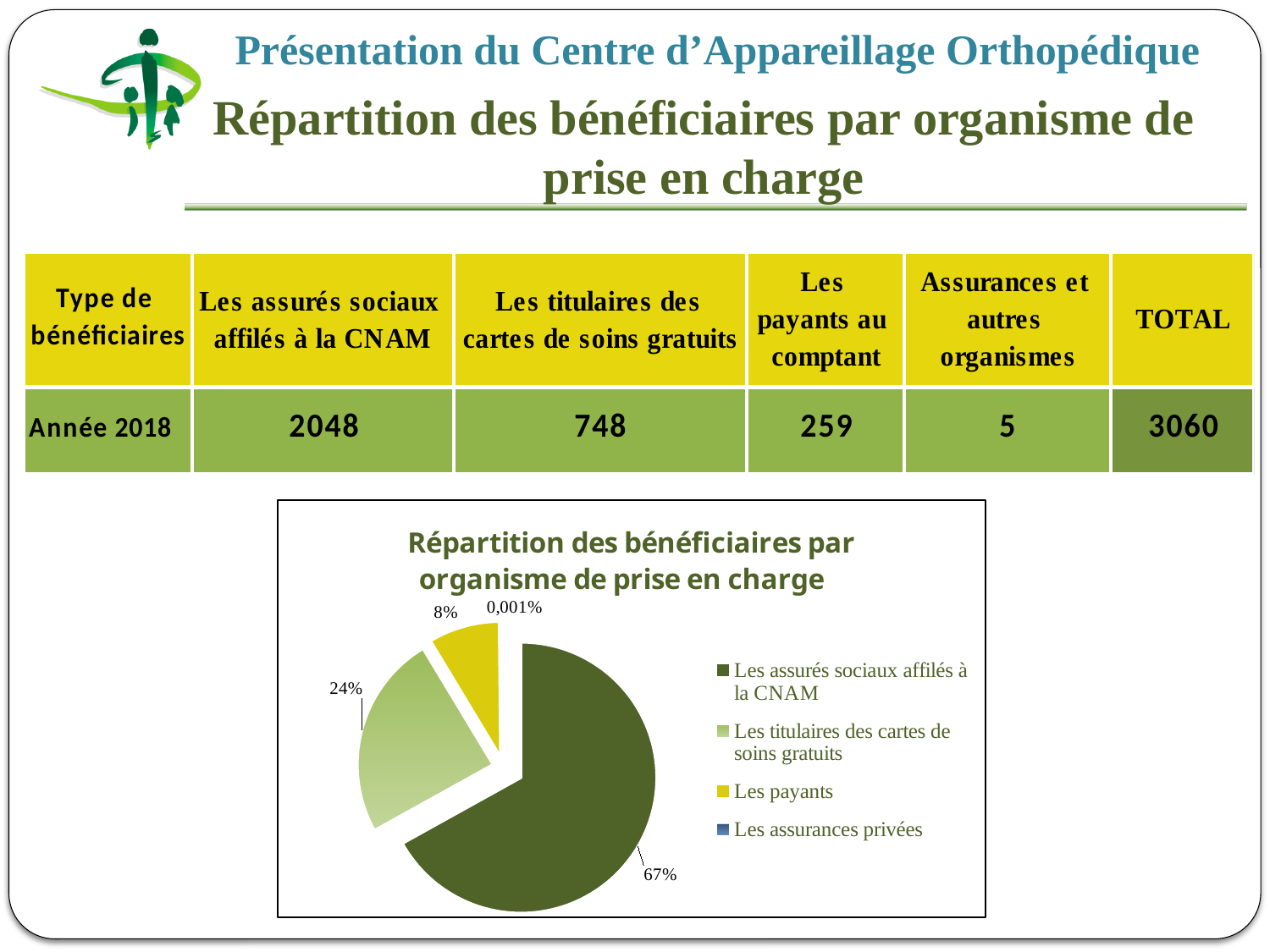
What is the difference in percentage points between the 'Les assurés sociaux affilés à la CNAM' slice and the 'Les titulaires des cartes de soins gratuits' slice? 43 What share of the pie is labelled for 'Les titulaires des cartes de soins gratuits'? 24% What is the title of the chart? Répartition des bénéficiaires par organisme de prise en charge Which legend category has the largest slice of the pie? Les assurés sociaux affilés à la CNAM What share of the pie is labelled for 'Les assurés sociaux affilés à la CNAM'? 67% What kind of chart is shown on the slide? pie chart How many entries does the chart legend list? 4 Which legend category has the smallest slice of the pie? Les assurances privées What colour is the slice for 'Les payants' in the pie chart? yellow What share of the pie is labelled for 'Les assurances privées'? 0,001% Which slice is larger: 'Les titulaires des cartes de soins gratuits' or 'Les payants'? Les titulaires des cartes de soins gratuits What share of the pie is labelled for 'Les payants'? 8%